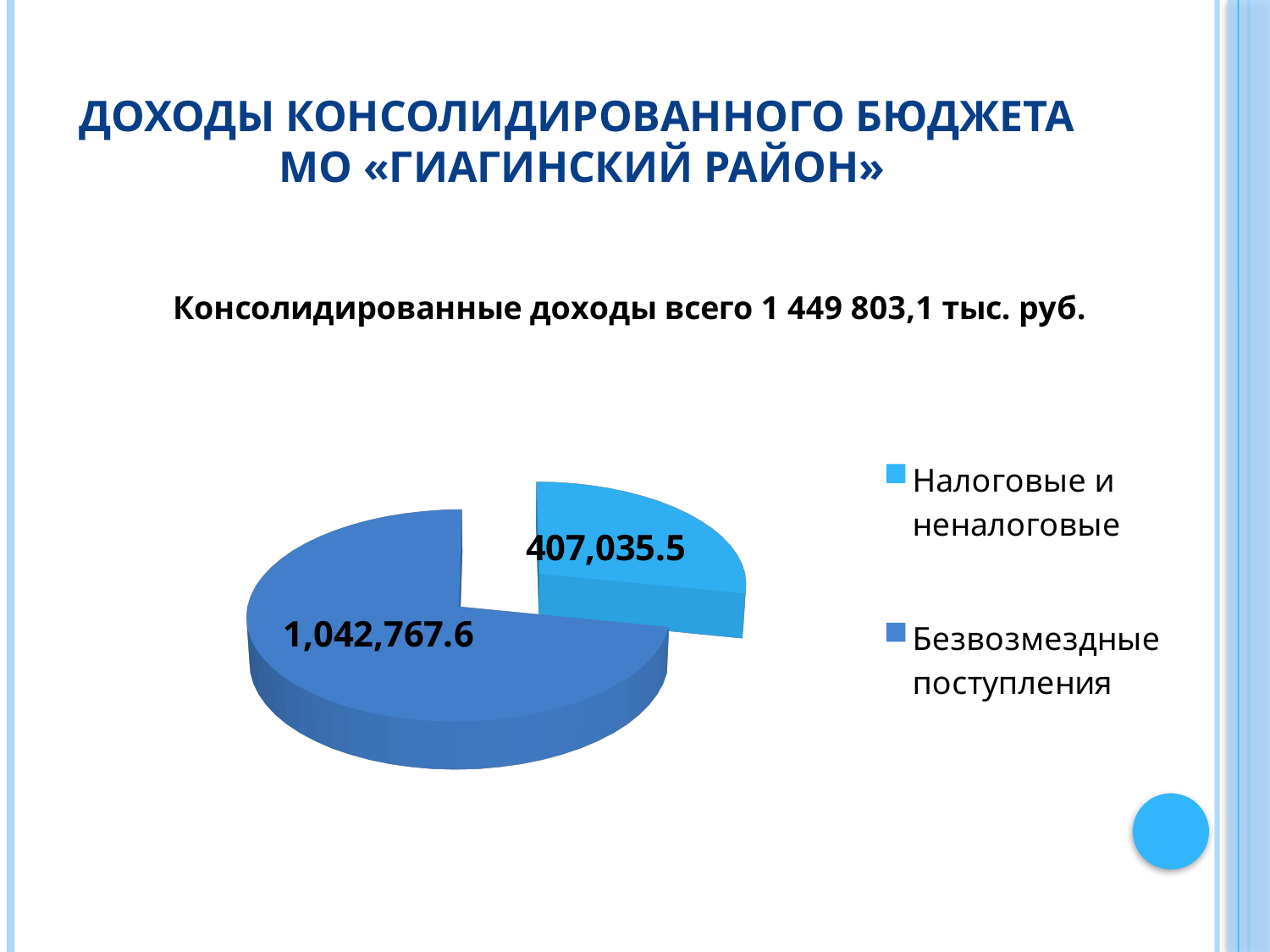
What is the value for «Безвозмездные поступления» in the pie chart? 1,042,767.6 How many entries does the legend list? 2 Which category has the smallest slice of the pie chart? Налоговые и неналоговые What is the difference between «Безвозмездные поступления» and «Налоговые и неналоговые»? 635,732.1 Which is larger: «Налоговые и неналоговые» or «Безвозмездные поступления»? Безвозмездные поступления What total consolidated revenue is stated above the chart? 1 449 803,1 тыс. руб. What is the value for «Налоговые и неналоговые» in the pie chart? 407,035.5 How many slices does the pie chart have? 2 What type of chart is shown on the slide? Pie chart Which category has the largest slice of the pie chart? Безвозмездные поступления Which legend entry is shown in the lighter blue colour? Налоговые и неналоговые